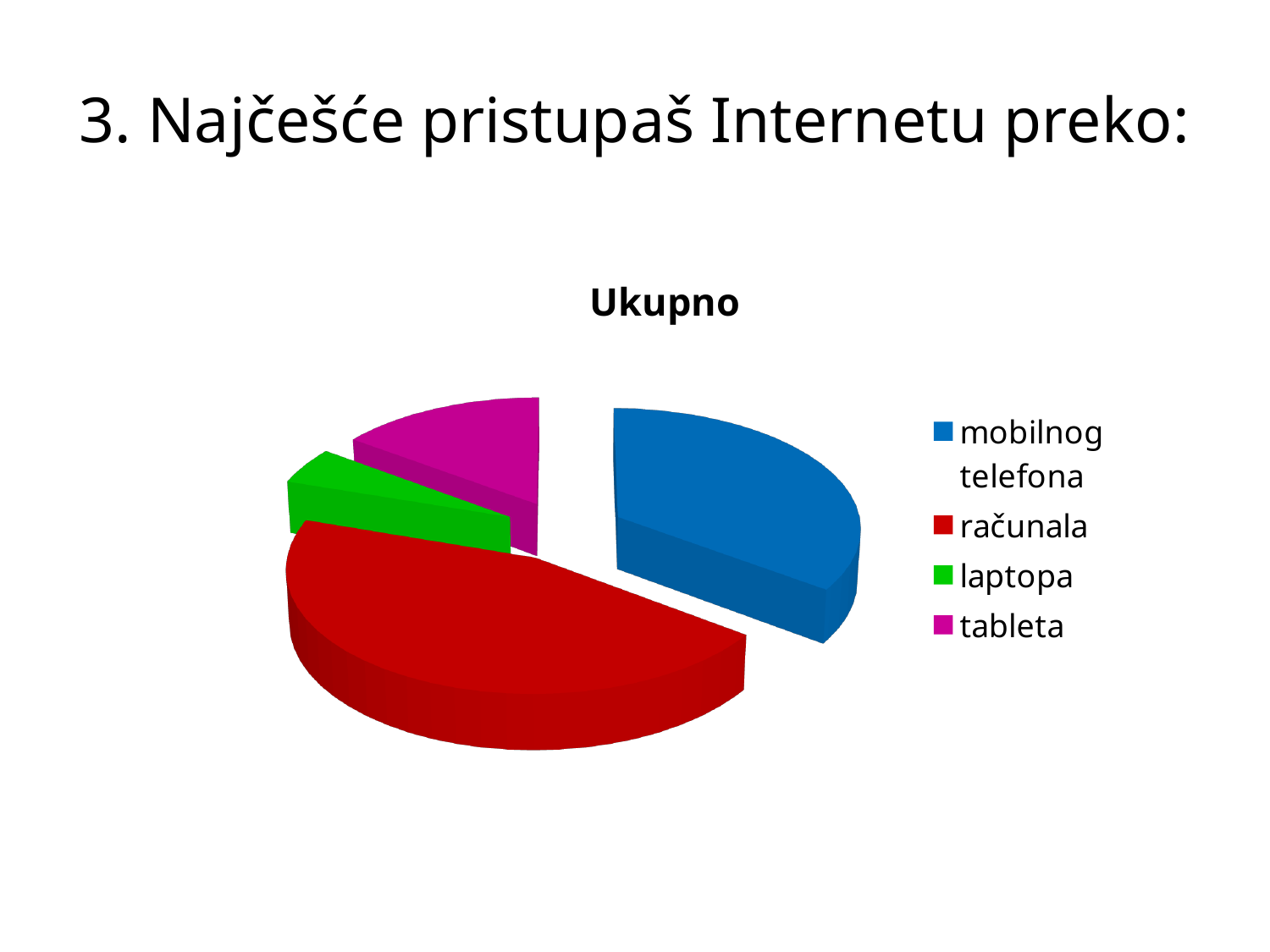
Which slice is larger, tableta or laptopa? tableta How many categories (slices) does the pie chart have? 4 How many entries does the legend list? 4 What kind of chart is shown on the slide? pie chart Which category has the largest slice of the pie? računala What is the title of the chart? Ukupno Which category has the smallest slice of the pie? laptopa Which slice is larger, mobilnog telefona or tableta? mobilnog telefona Which colour represents the category računala in the pie chart? red Which slice is larger, računala or mobilnog telefona? računala